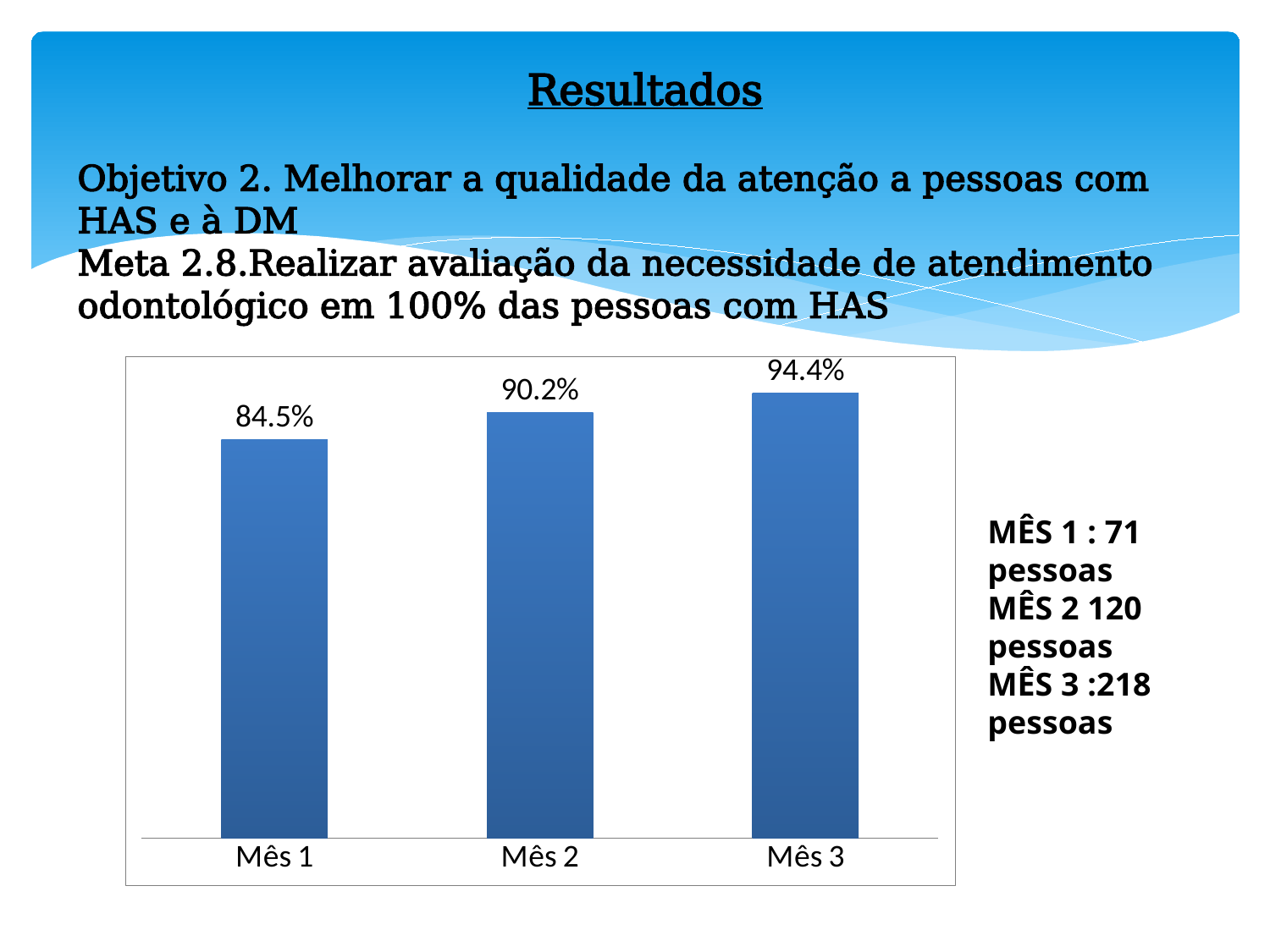
What is the value for Mês 3? 94.4% What is the value for Mês 1? 84.5% Which month has the lowest value? Mês 1 What is the difference between the values for Mês 3 and Mês 1? 9.9% According to the text beside the chart, how many people does Mês 3 correspond to? 218 pessoas How many bars are shown in the chart? 3 Which month has the highest value? Mês 3 What is the difference between the values for Mês 2 and Mês 1? 5.7% What is the value for Mês 2? 90.2% Which is larger, the value for Mês 2 or the value for Mês 3? Mês 3 What kind of chart is shown on the slide? Bar chart Do the values rise or fall from Mês 1 to Mês 3? Rise